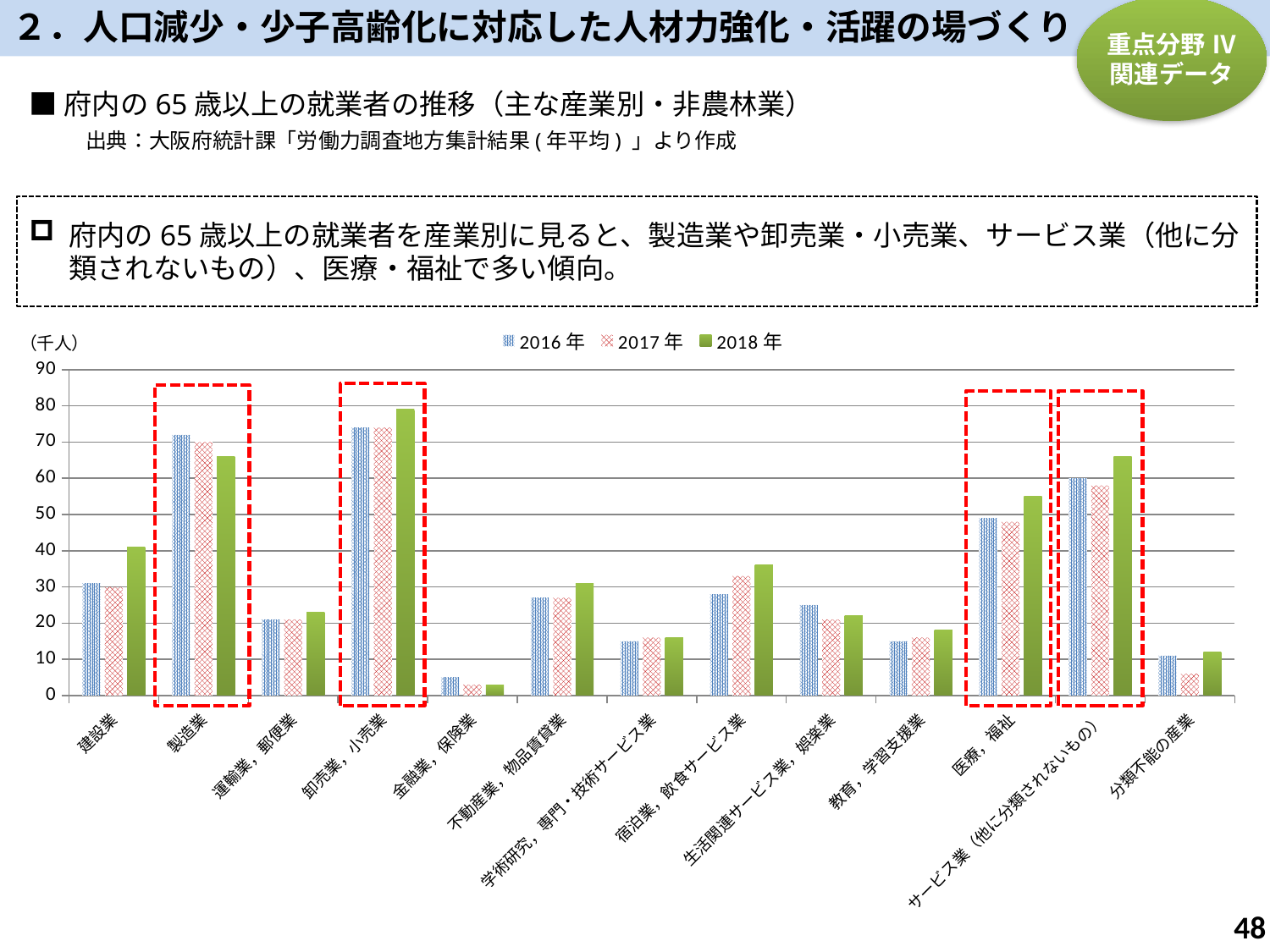
What kind of chart is shown on the slide? bar chart Is the value for 医療，福祉 in 2018年 greater or less than 50? greater For 製造業, do the values rise or fall from 2016年 to 2018年? fall Is the value for 金融業，保険業 in 2016年 greater or less than 10? less Which industry has the highest value for 2018年? 卸売業，小売業 Is the value for 製造業 in 2018年 greater or less than 60? greater Which is larger in 2018年: 製造業 or 卸売業，小売業? 卸売業，小売業 Which industry has the lowest value for 2018年? 金融業，保険業 What unit is shown for the y axis of the chart? 千人 How many series does the legend list? 3 How many industry categories are shown on the x axis? 13